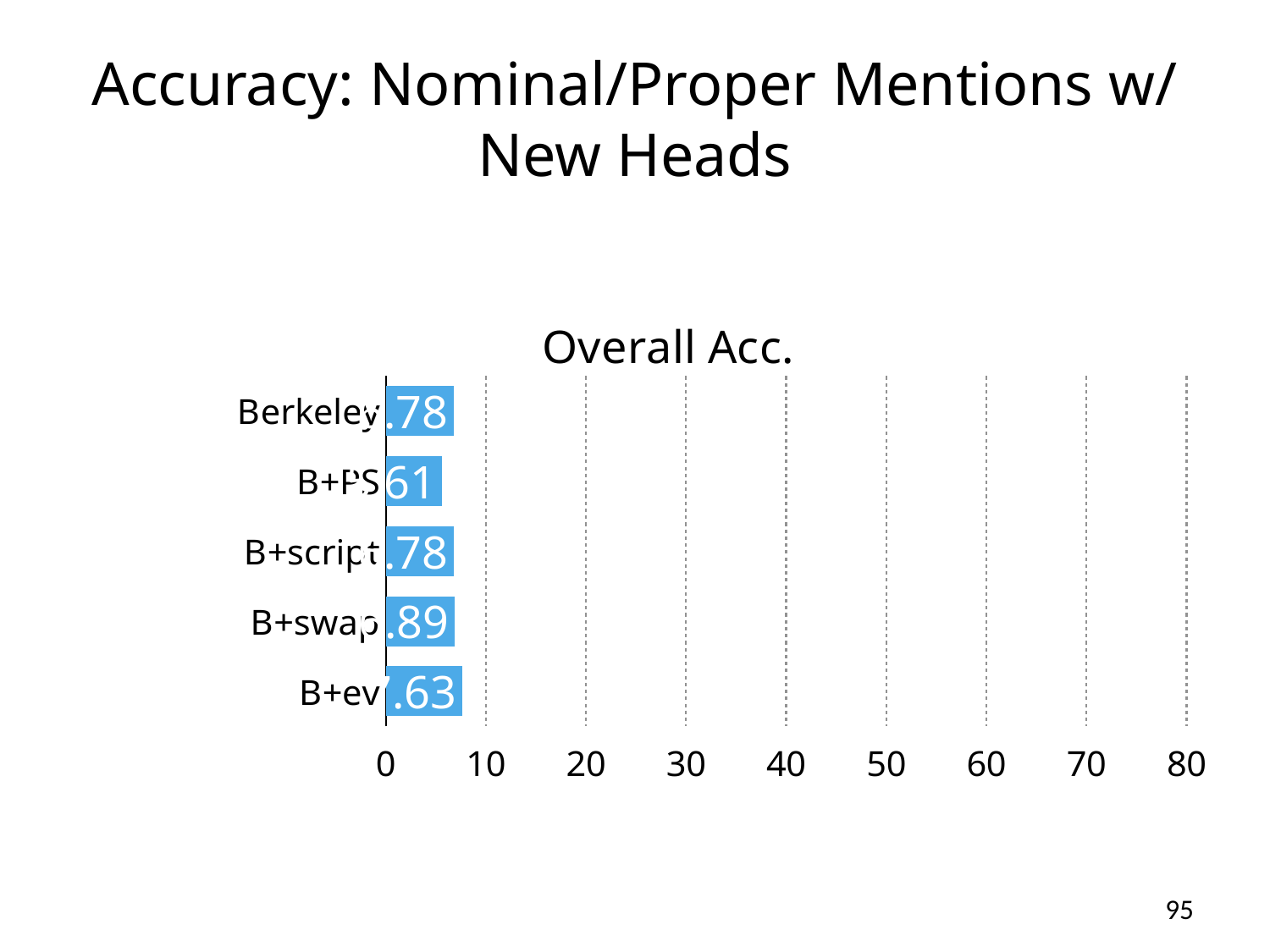
Is the value for B+script greater or less than 20? less Is the value for Berkeley greater or less than 10? less Is the value for B+PS greater or less than 10? less What is the title of the chart? Overall Acc. Which category is listed at the top of the chart? Berkeley What kind of chart is shown on the slide? bar chart How many categories are plotted in the chart? 5 Which is larger, the value for B+ev or the value for B+PS? B+ev What is the highest value shown on the x axis? 80